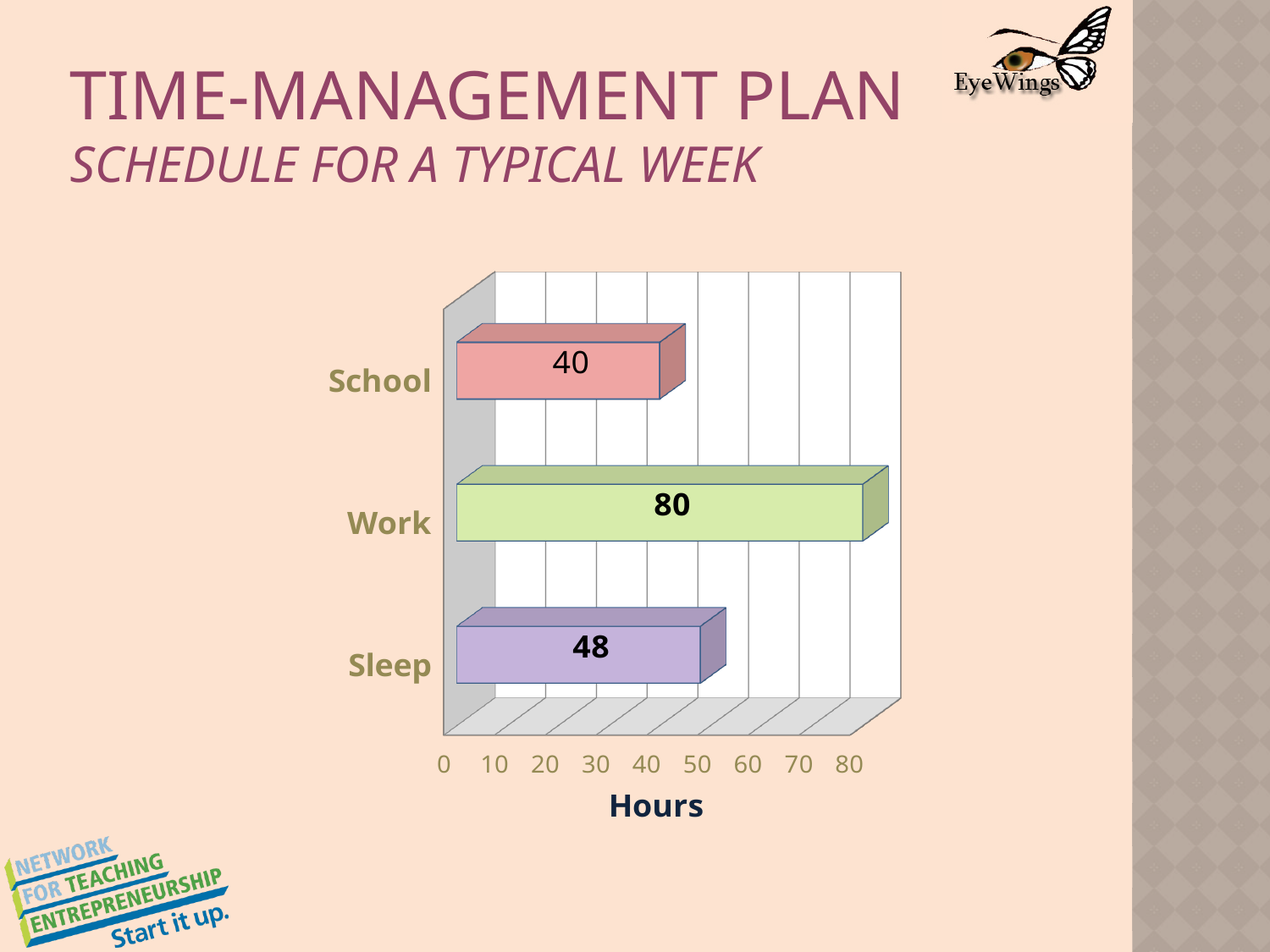
What is the difference in hours between Work and School? 40 How many hours are shown for Sleep? 48 How many hours are shown for School? 40 What is the difference in hours between Sleep and School? 8 What is the label of the horizontal axis? Hours Is the value for Sleep greater or less than 50? less Which category has the highest number of hours? Work Which category has the lowest number of hours? School How many categories are shown in the chart? 3 Which has more hours, Sleep or School? Sleep What kind of chart is shown on the slide? Bar chart How many hours are shown for Work? 80